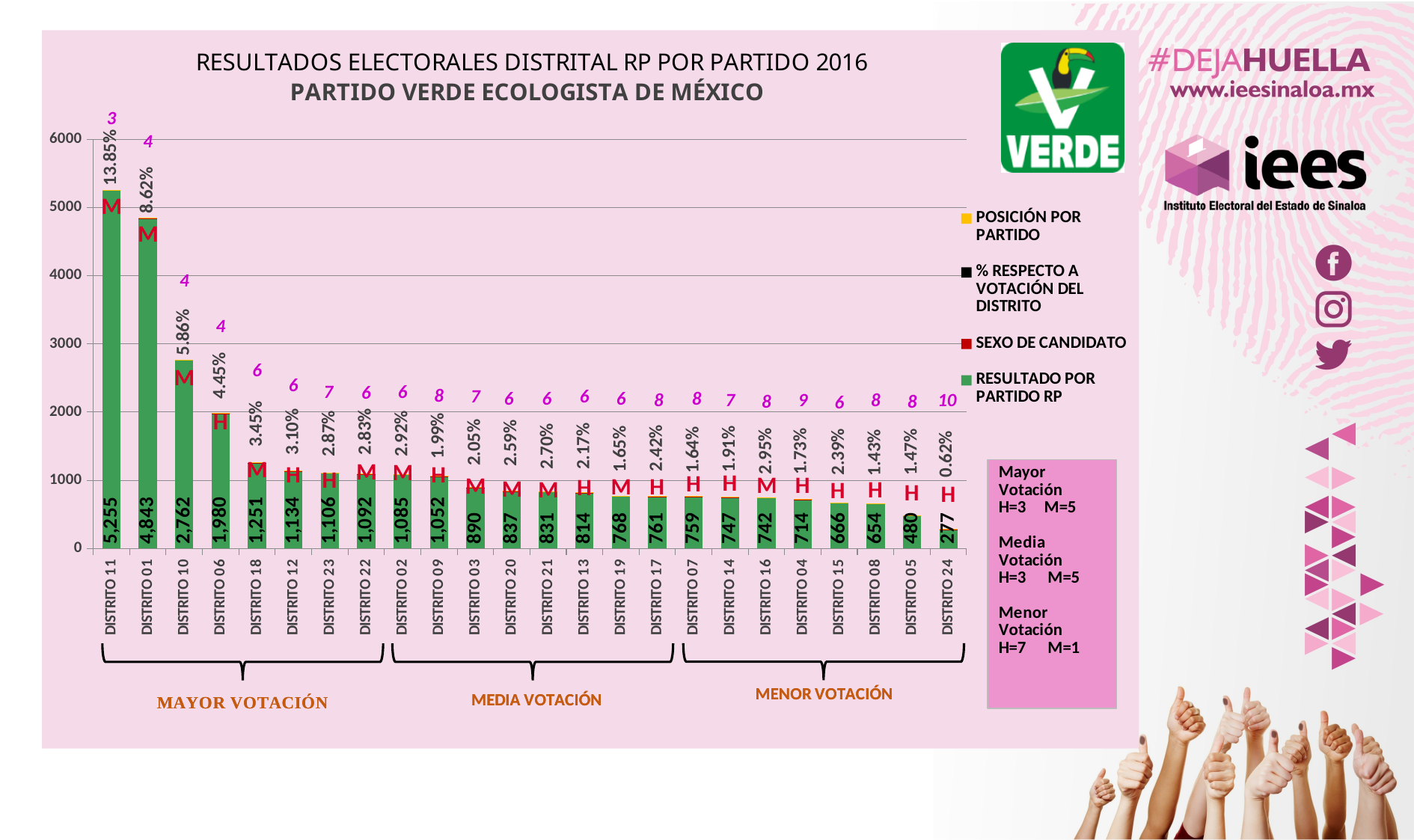
How many series does the chart legend list? 4 Which has a larger RESULTADO POR PARTIDO RP value, DISTRITO 06 or DISTRITO 18? DISTRITO 06 Which district has the highest RESULTADO POR PARTIDO RP value? DISTRITO 11 What is the RESULTADO POR PARTIDO RP value for DISTRITO 24? 277 How many districts are shown on the x axis of the chart? 24 What percentage (% RESPECTO A VOTACIÓN DEL DISTRITO) is shown for DISTRITO 10? 5.86% What kind of chart is shown on the slide? bar chart Which district has the lowest RESULTADO POR PARTIDO RP value? DISTRITO 24 What is the RESULTADO POR PARTIDO RP value for DISTRITO 11? 5,255 What is the difference between the RESULTADO POR PARTIDO RP values of DISTRITO 11 and DISTRITO 01? 412 Is the RESULTADO POR PARTIDO RP value for DISTRITO 10 greater or less than 2000? greater Do the RESULTADO POR PARTIDO RP values rise or fall from left to right along the x axis? fall